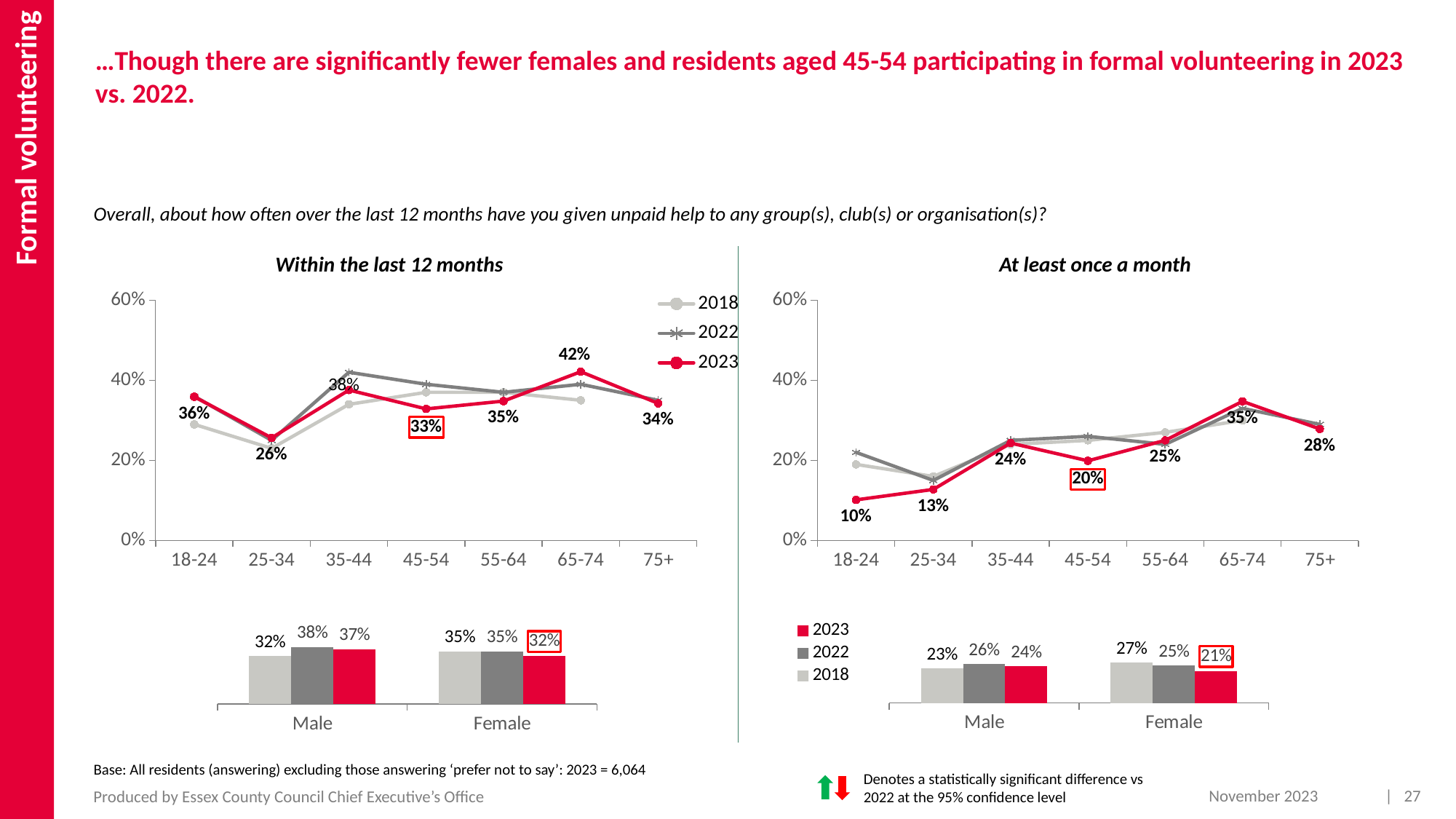
In the 'Within the last 12 months' gender bar chart, which is larger for Female: the 2018 value or the 2023 value? 2018 In the 'At least once a month' gender bar chart, what is the 2023 value for Female? 21% In the 'Within the last 12 months' line chart, which age group has the lowest 2023 value? 25-34 In the 'Within the last 12 months' line chart, what is the 2023 value for residents aged 65-74? 42% In the 'Within the last 12 months' gender bar chart, what is the 2022 value for Male? 38% In the 'At least once a month' gender bar chart, what is the difference between the 2022 and 2023 values for Male? 2 percentage points In the 'Within the last 12 months' line chart, how many age groups are shown on the x axis? 7 How many series does the legend of the 'Within the last 12 months' line chart list? 3 In the 'At least once a month' line chart, what is the 2023 value for residents aged 45-54? 20% In the 'At least once a month' line chart, which age group has the highest 2023 value? 65-74 In the 'At least once a month' line chart, what is the difference between the 2023 values for 65-74 and 18-24? 25 percentage points What type of chart is used to show the Male and Female breakdown under 'At least once a month'? Bar chart